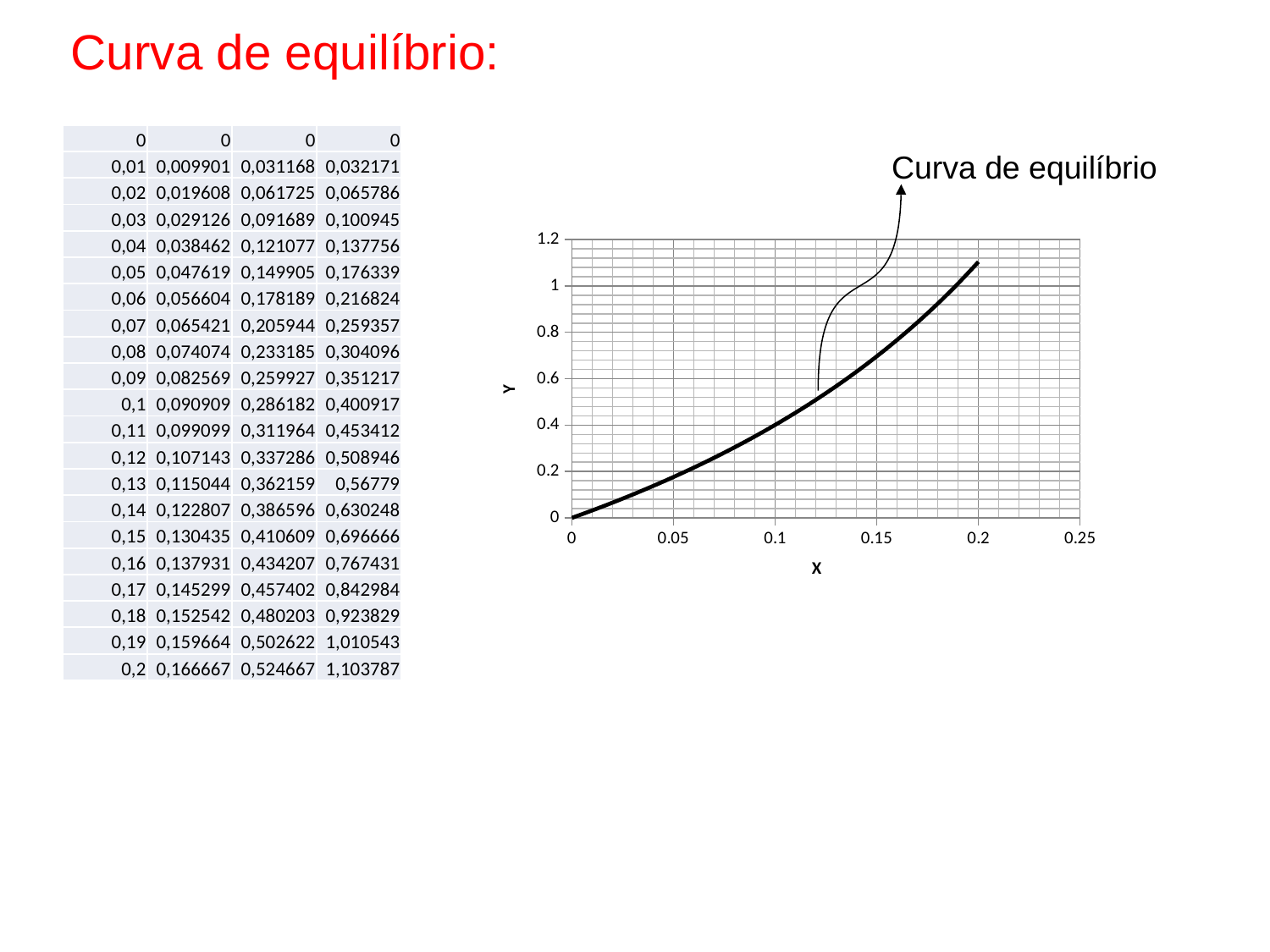
Is the value of Y at X = 0.15 greater or less than 0.6? greater Does the curve rise or fall as X increases? rises Is the value of Y at X = 0.12 greater or less than 0.4? greater Is the value of Y at X = 0.15 greater or less than 0.8? less What label is attached by the arrow to the curve in the chart? Curva de equilíbrio Which has a larger Y value on the curve, X = 0.1 or X = 0.2? X = 0.2 What is the highest tick value shown on the Y axis? 1.2 What kind of chart is shown on the slide? line chart What is the value of Y at X = 0 on the curve? 0